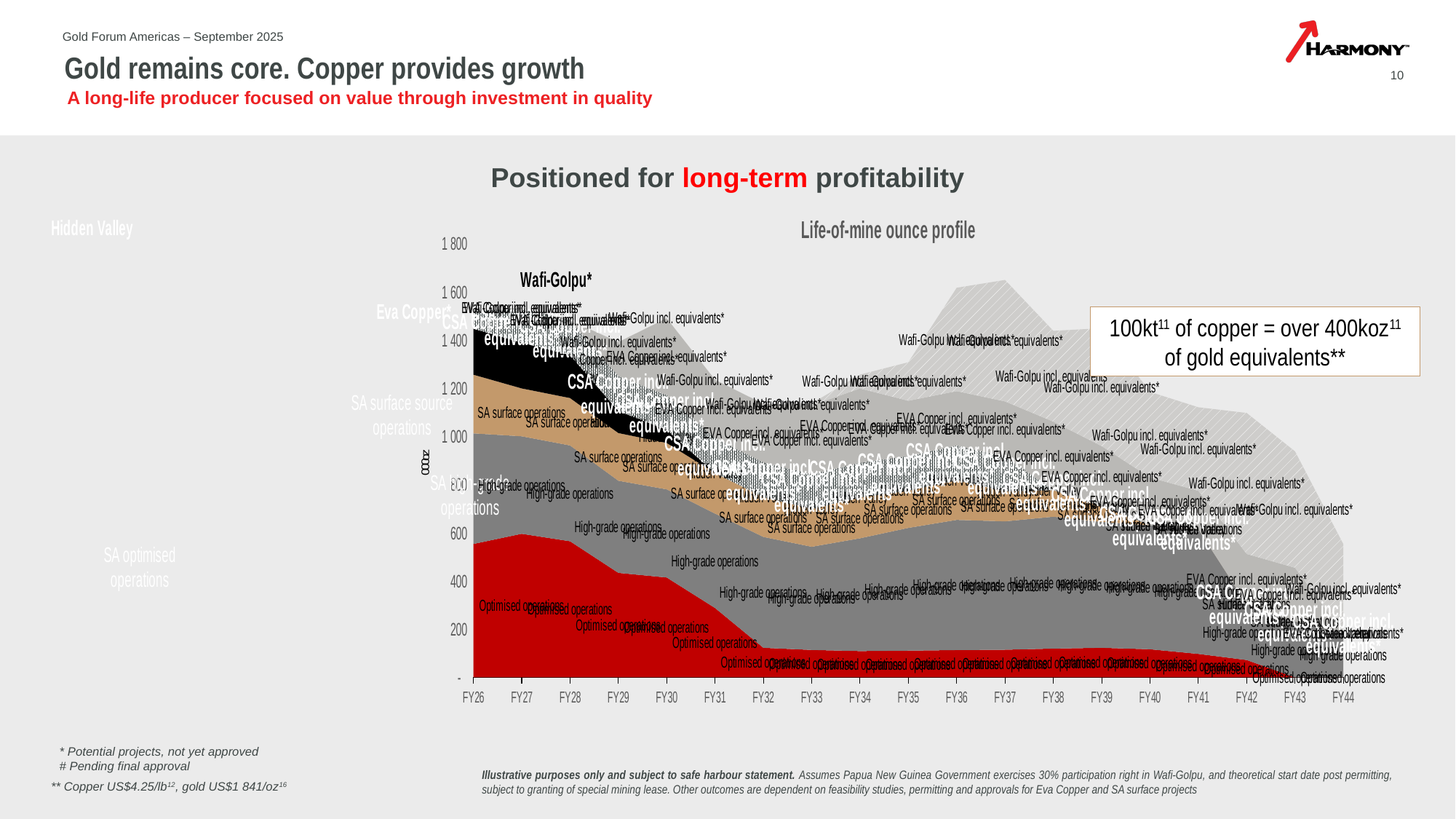
Is the value for Optimised operations in FY27 greater or less than 400? greater What is the title of the chart? Life-of-mine ounce profile What is the last fiscal year shown on the x axis? FY44 How many fiscal years are shown along the x axis of the chart? 19 Does the Optimised operations series rise or fall from FY26 to FY33? fall Is the total stacked value for FY37 greater or less than 1 400? greater What kind of chart is shown on the slide? Stacked area chart What is the highest value labelled on the y axis? 1 800 Is the total stacked value for FY44 greater or less than 1 000? less What is the first fiscal year shown on the x axis? FY26